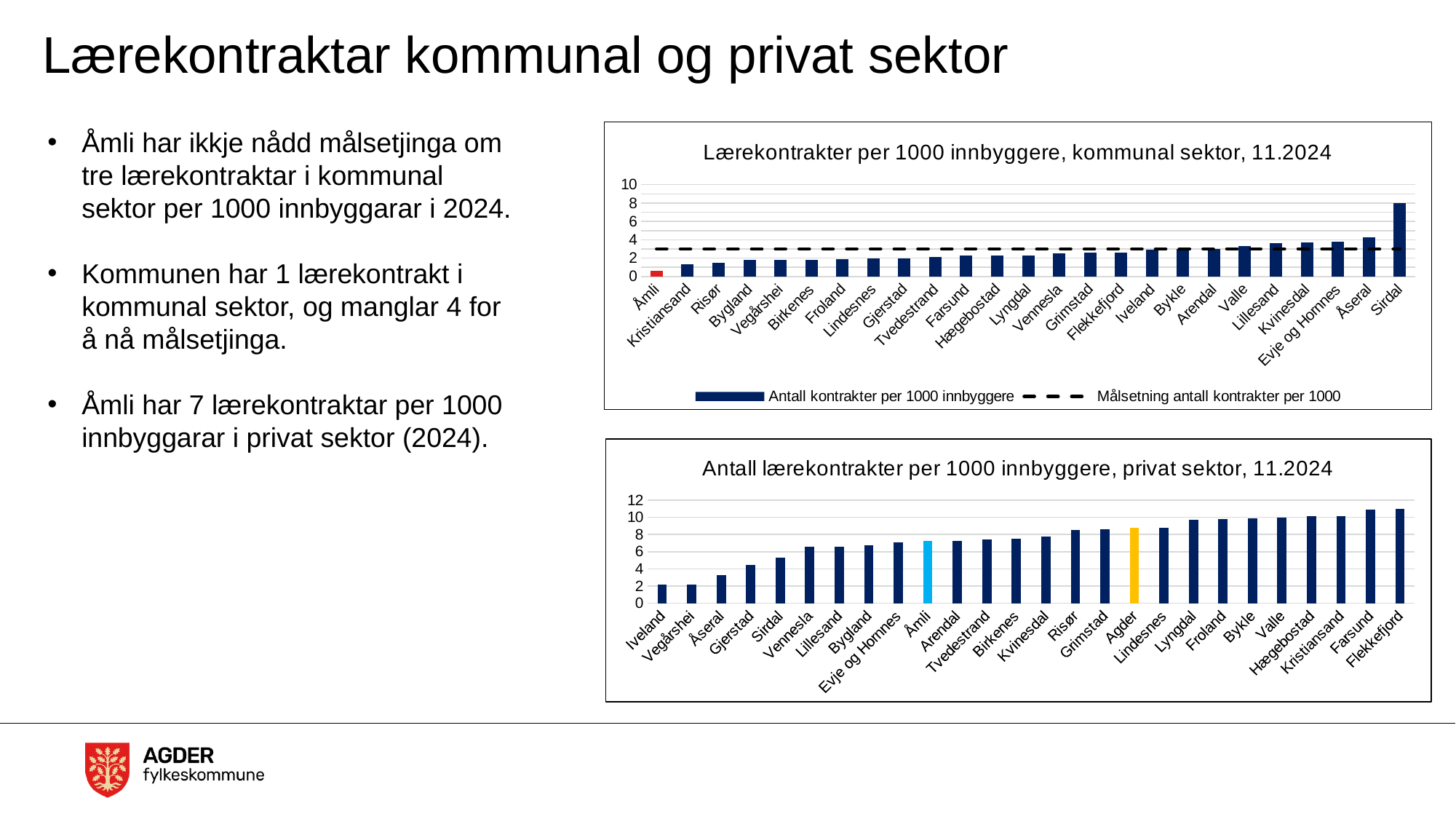
How many entries does the legend of the top chart (kommunal sektor) list? 2 In the top chart (kommunal sektor), is the value for Sirdal greater or less than 6? greater In the top chart (kommunal sektor), which is larger, the value for Sirdal or the value for Åseral? Sirdal In the bottom chart (privat sektor), is the value for Åmli greater or less than 6? greater In the top chart (kommunal sektor), is the value for Kristiansand greater or less than 2? less In the bottom chart (privat sektor), which is larger, the value for Flekkefjord or the value for Gjerstad? Flekkefjord What type of chart is the top chart, 'Lærekontrakter per 1000 innbyggere, kommunal sektor, 11.2024'? Combination bar and line chart (bars with a dashed target line) In the top chart (kommunal sektor), which municipality has the highest value? Sirdal How many municipalities are shown in the bottom chart, 'Antall lærekontrakter per 1000 innbyggere, privat sektor, 11.2024'? 26 In the top chart (kommunal sektor), which municipality has the lowest value? Åmli In the top chart (kommunal sektor), do the bar values rise or fall from left to right along the x axis? Rise